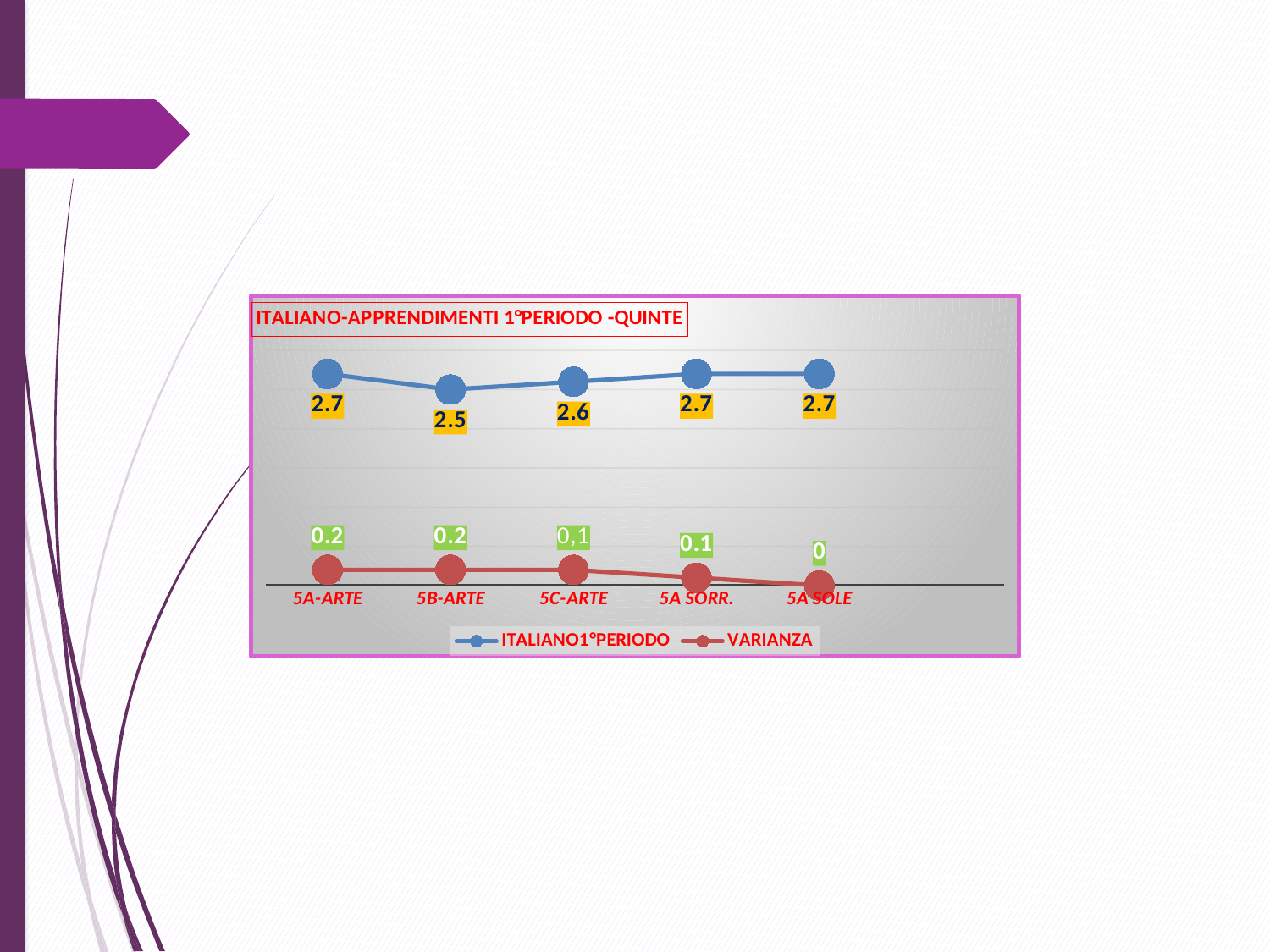
How many series does the legend list? 2 Which category has the lowest ITALIANO1°PERIODO value? 5B-ARTE What is the ITALIANO1°PERIODO value for 5C-ARTE? 2.6 What is the VARIANZA value for 5A-ARTE? 0.2 Which is larger, the ITALIANO1°PERIODO value for 5C-ARTE or for 5A SORR.? 5A SORR. What is the ITALIANO1°PERIODO value for 5B-ARTE? 2.5 Does the VARIANZA series rise or fall from 5A-ARTE to 5A SOLE? Fall How many categories are shown on the x axis? 5 What kind of chart is shown on the slide? Line chart What is the title of the chart? ITALIANO-APPRENDIMENTI 1°PERIODO -QUINTE What is the difference between the ITALIANO1°PERIODO values for 5A-ARTE and 5B-ARTE? 0.2 What is the VARIANZA value for 5A SOLE? 0